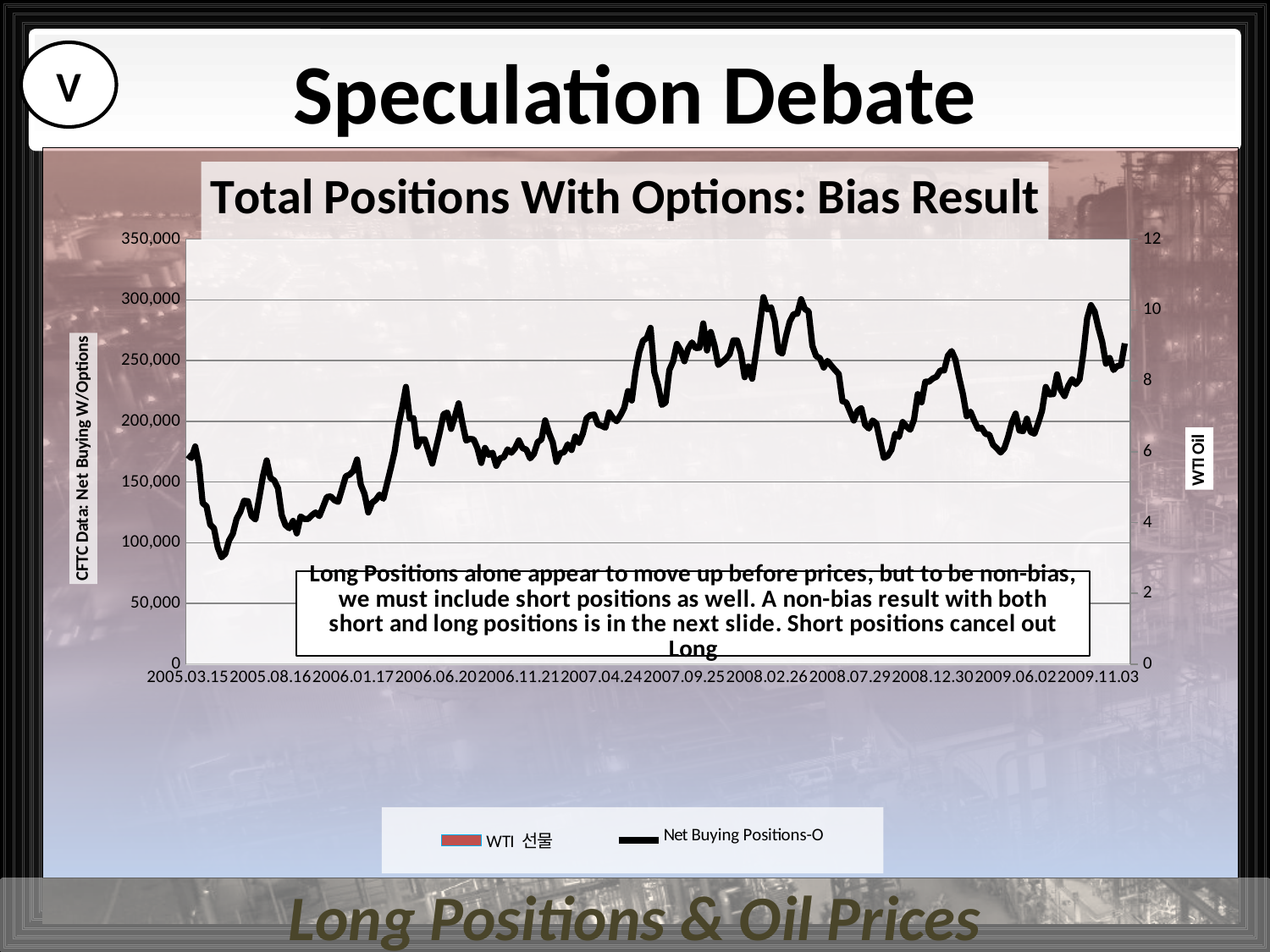
What is the first date label on the x axis? 2005.03.15 Is the Net Buying Positions-O value at 2005.03.15 greater or less than 150,000? greater What is the title of the left vertical axis? CFTC Data: Net Buying W/Options What is the title of the chart? Total Positions With Options: Bias Result Is the Net Buying Positions-O value around 2008.12.30 greater or less than 250,000? less Does the Net Buying Positions-O line generally rise or fall between 2005.08.16 and 2008.02.26? rise Is the highest Net Buying Positions-O value on the chart greater or less than 250,000? greater How many series does the chart legend list? 2 What kind of chart is shown on the slide? line chart What is the maximum value shown on the left vertical axis? 350,000